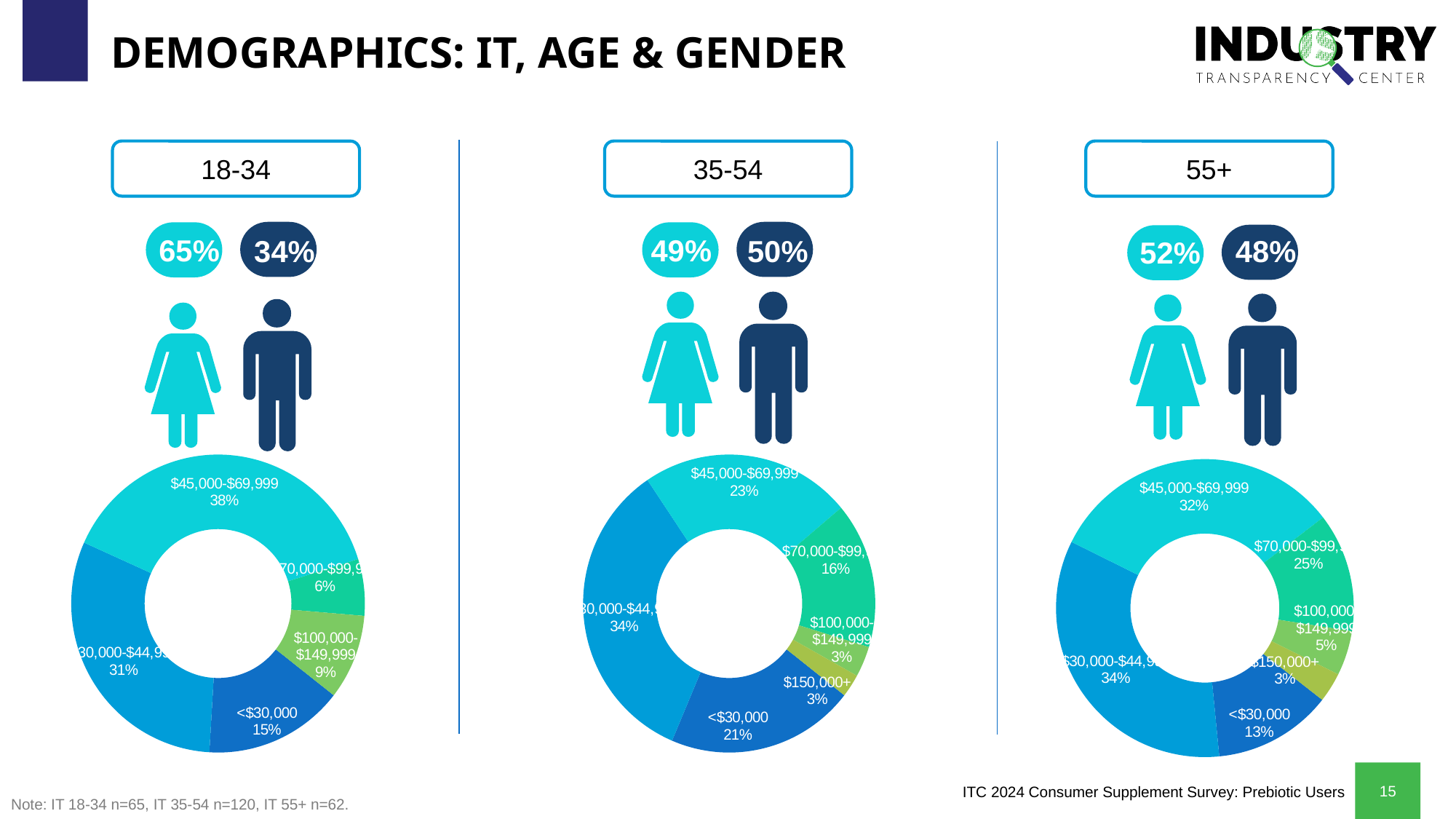
In the 55+ donut chart, which income bracket has the smallest share? $150,000+ How many income brackets are shown in the 18-34 donut chart? 5 How many income brackets are shown in the 35-54 donut chart? 6 In the 18-34 donut chart, what share is labelled for the $45,000-$69,999 income bracket? 38% In the 55+ donut chart, what share is labelled for the $70,000-$99,999 income bracket? 25% In the 55+ donut chart, what is the difference between the $45,000-$69,999 share and the <$30,000 share? 19 percentage points In the 18-34 donut chart, which income bracket has the largest share? $45,000-$69,999 In the 35-54 donut chart, which income bracket has the largest share? $30,000-$44,999 What type of chart is used to show the income breakdown for each age group? Donut (pie) chart In the 35-54 donut chart, which is larger: the share for $45,000-$69,999 or the share for <$30,000? $45,000-$69,999 In the 35-54 donut chart, what share is labelled for the <$30,000 income bracket? 21% In the 18-34 donut chart, which income bracket has the smallest share? $70,000-$99,999